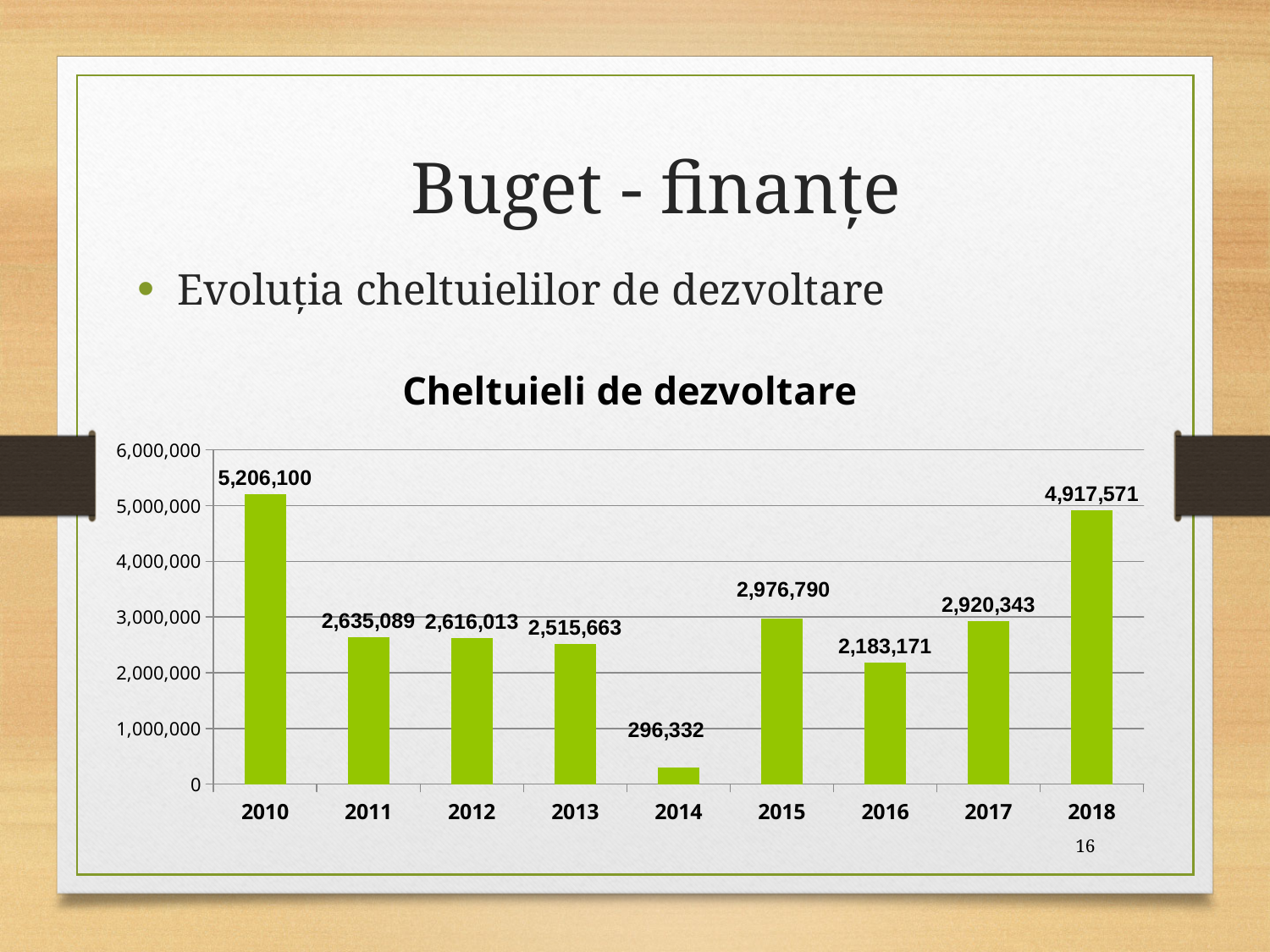
Which is larger in the Cheltuieli de dezvoltare chart, the value for 2015 or the value for 2017? 2015 How many years are shown on the x axis of the Cheltuieli de dezvoltare chart? 9 What is the value for 2010 in the Cheltuieli de dezvoltare chart? 5,206,100 Which year has the highest value in the Cheltuieli de dezvoltare chart? 2010 What is the difference between the values for 2015 and 2016 in the Cheltuieli de dezvoltare chart? 793,619 What is the difference between the values for 2010 and 2018 in the Cheltuieli de dezvoltare chart? 288,529 Is the value for 2016 in the Cheltuieli de dezvoltare chart greater or less than 3,000,000? less Do the values in the Cheltuieli de dezvoltare chart rise or fall from 2010 to 2014? fall What is the value for 2017 in the Cheltuieli de dezvoltare chart? 2,920,343 Which year has the lowest value in the Cheltuieli de dezvoltare chart? 2014 What is the value for 2014 in the Cheltuieli de dezvoltare chart? 296,332 What kind of chart is the Cheltuieli de dezvoltare chart? bar chart